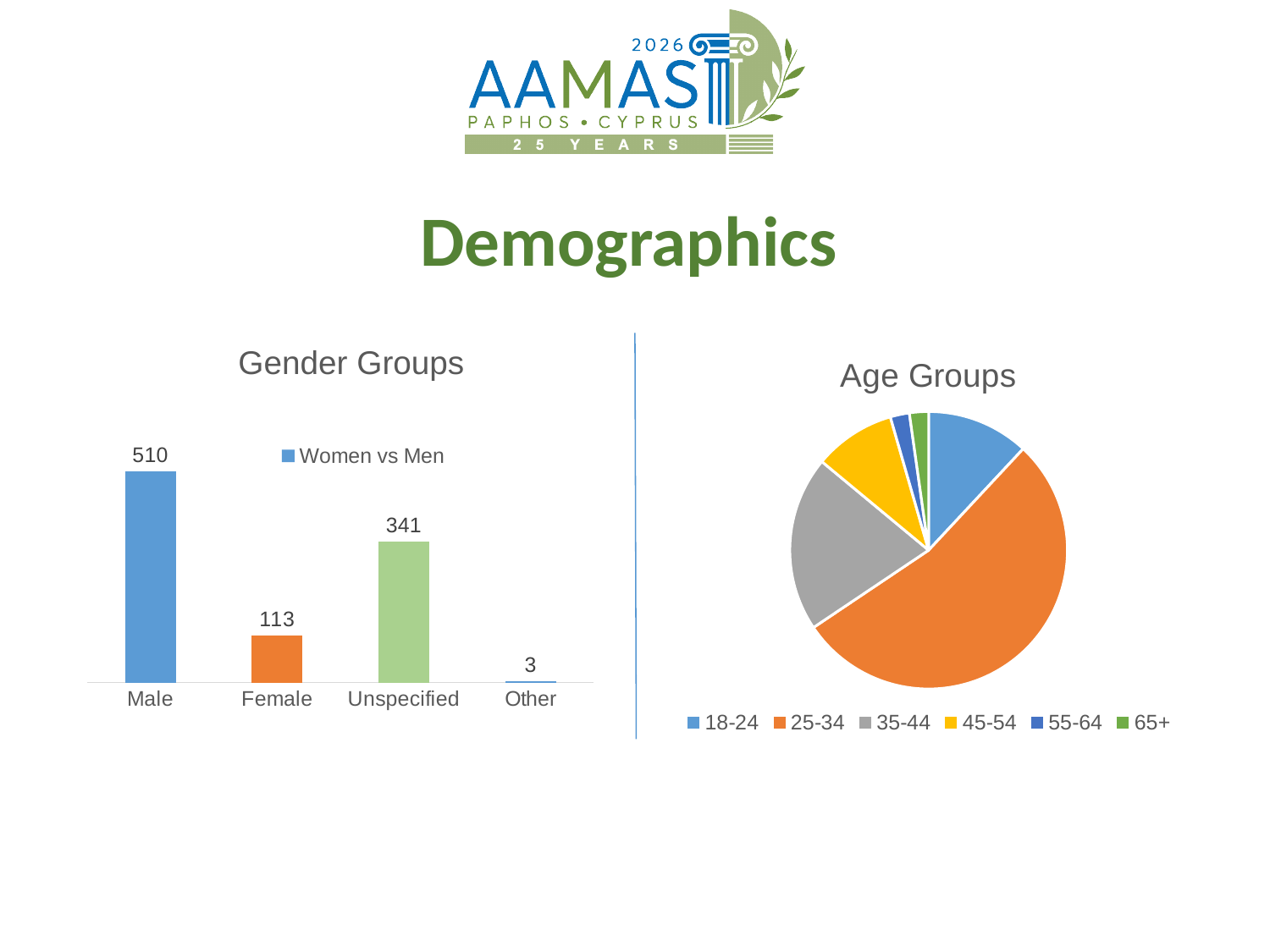
In the Gender Groups chart, which category has the highest value? Male In the Gender Groups chart, what is the value for Male? 510 What kind of chart is the Gender Groups chart? Bar chart In the Gender Groups chart, what is the value for Female? 113 In the Gender Groups chart, what is the difference between the Male and Female values? 397 How many categories are shown in the Gender Groups chart? 4 In the Gender Groups chart, which is larger, Female or Unspecified? Unspecified In the Age Groups chart, which age group has the largest slice? 25-34 What kind of chart is the Age Groups chart? Pie chart In the Gender Groups chart, what is the value for Unspecified? 341 How many age groups does the legend of the Age Groups chart list? 6 In the Gender Groups chart, which category has the lowest value? Other